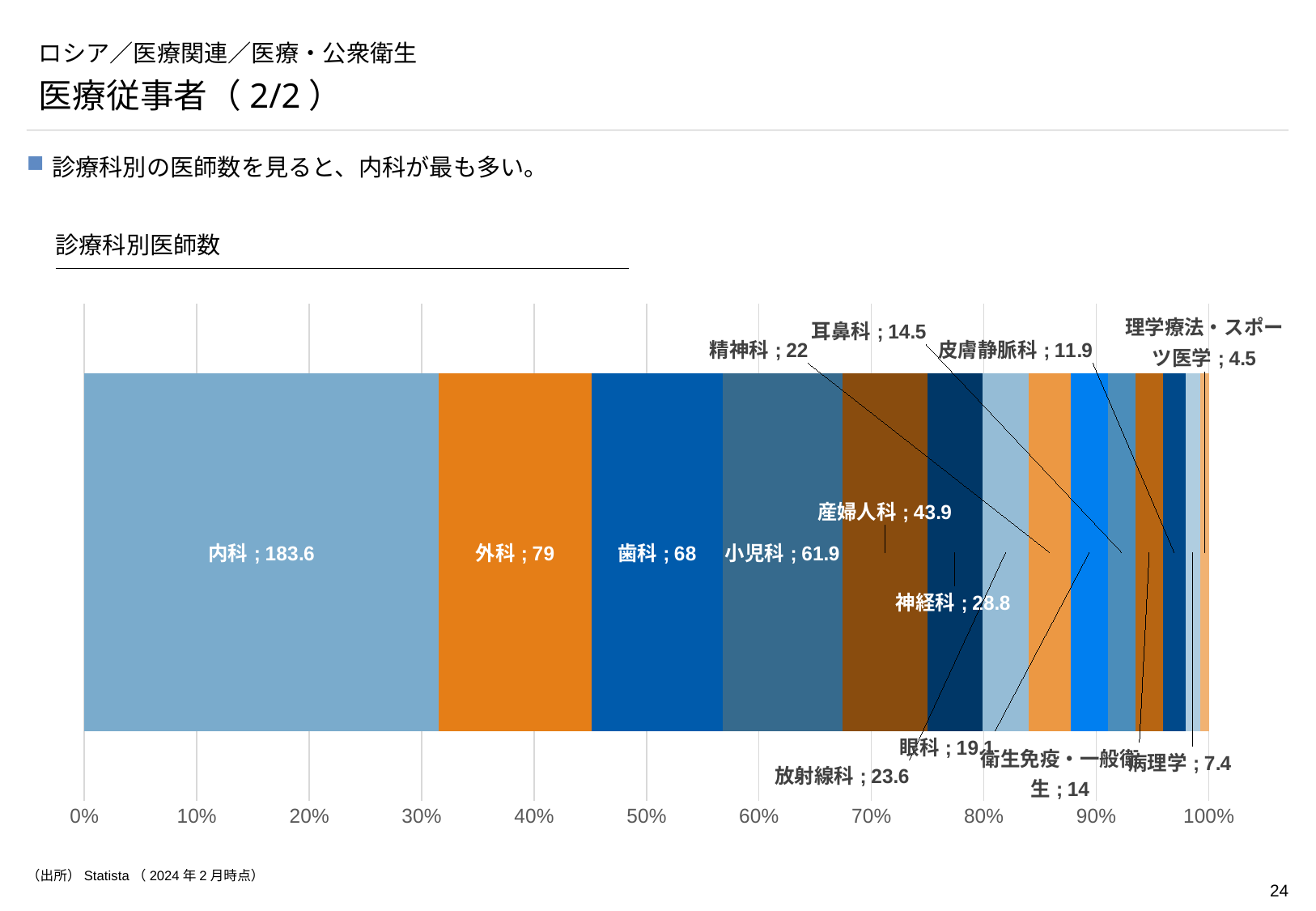
What is the value for 病理学 in the 診療科別医師数 chart? 7.4 How many departments (segments) are shown in the 診療科別医師数 chart? 14 What is the value for 小児科 in the 診療科別医師数 chart? 61.9 What is the difference between the values for 内科 and 外科 in the 診療科別医師数 chart? 104.6 What is the total of all segments in the 診療科別医師数 stacked bar? 582.2 What is the value for 内科 in the 診療科別医師数 chart? 183.6 What is the value for 神経科 in the 診療科別医師数 chart? 28.8 What is the difference between the values for 歯科 and 小児科 in the 診療科別医師数 chart? 6.1 Which is larger in the 診療科別医師数 chart, 放射線科 or 精神科? 放射線科 Which department has the lowest value in the 診療科別医師数 chart? 理学療法・スポーツ医学 What kind of chart is the 診療科別医師数 chart? bar chart Which department has the highest value in the 診療科別医師数 chart? 内科